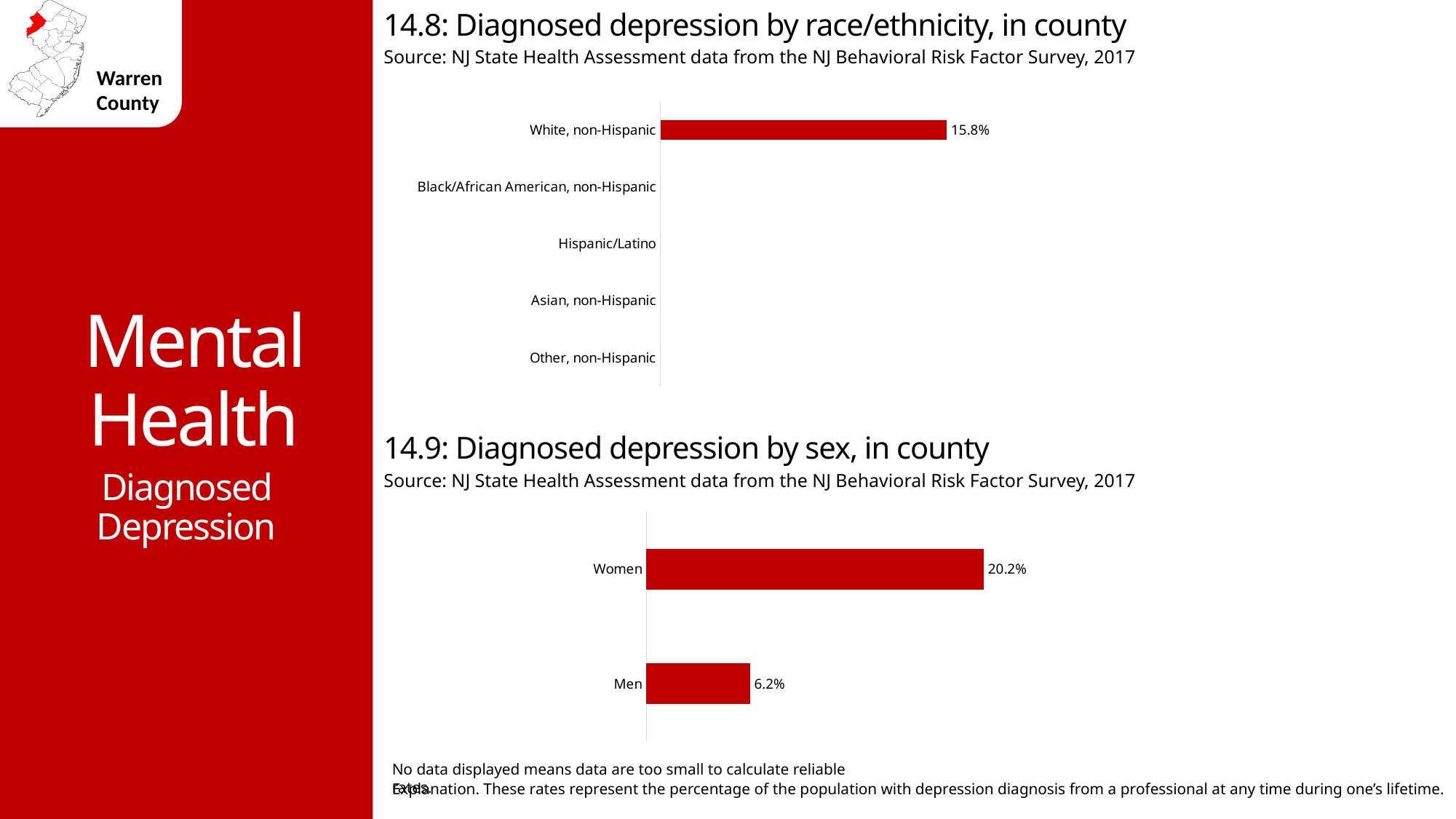
In chart 14.9 (Diagnosed depression by sex), how many categories are shown? 2 What kind of chart is chart 14.8 (Diagnosed depression by race/ethnicity)? Bar chart What kind of chart is chart 14.9 (Diagnosed depression by sex)? Bar chart In chart 14.9 (Diagnosed depression by sex), what is the value for Women? 20.2% In chart 14.8 (Diagnosed depression by race/ethnicity), what is the value for White, non-Hispanic? 15.8% In chart 14.9 (Diagnosed depression by sex), what is the difference between the values for Women and Men? 14 percentage points In chart 14.9 (Diagnosed depression by sex), which category has the higher value? Women In chart 14.9 (Diagnosed depression by sex), which category has the lower value? Men In chart 14.8 (Diagnosed depression by race/ethnicity), how many race/ethnicity categories are listed on the axis? 5 Which chart on the slide has the title '14.9: Diagnosed depression by sex, in county' — the top or the bottom chart? The bottom chart In chart 14.9 (Diagnosed depression by sex), what is the value for Men? 6.2% In chart 14.8 (Diagnosed depression by race/ethnicity), which category is the only one with a bar displayed? White, non-Hispanic